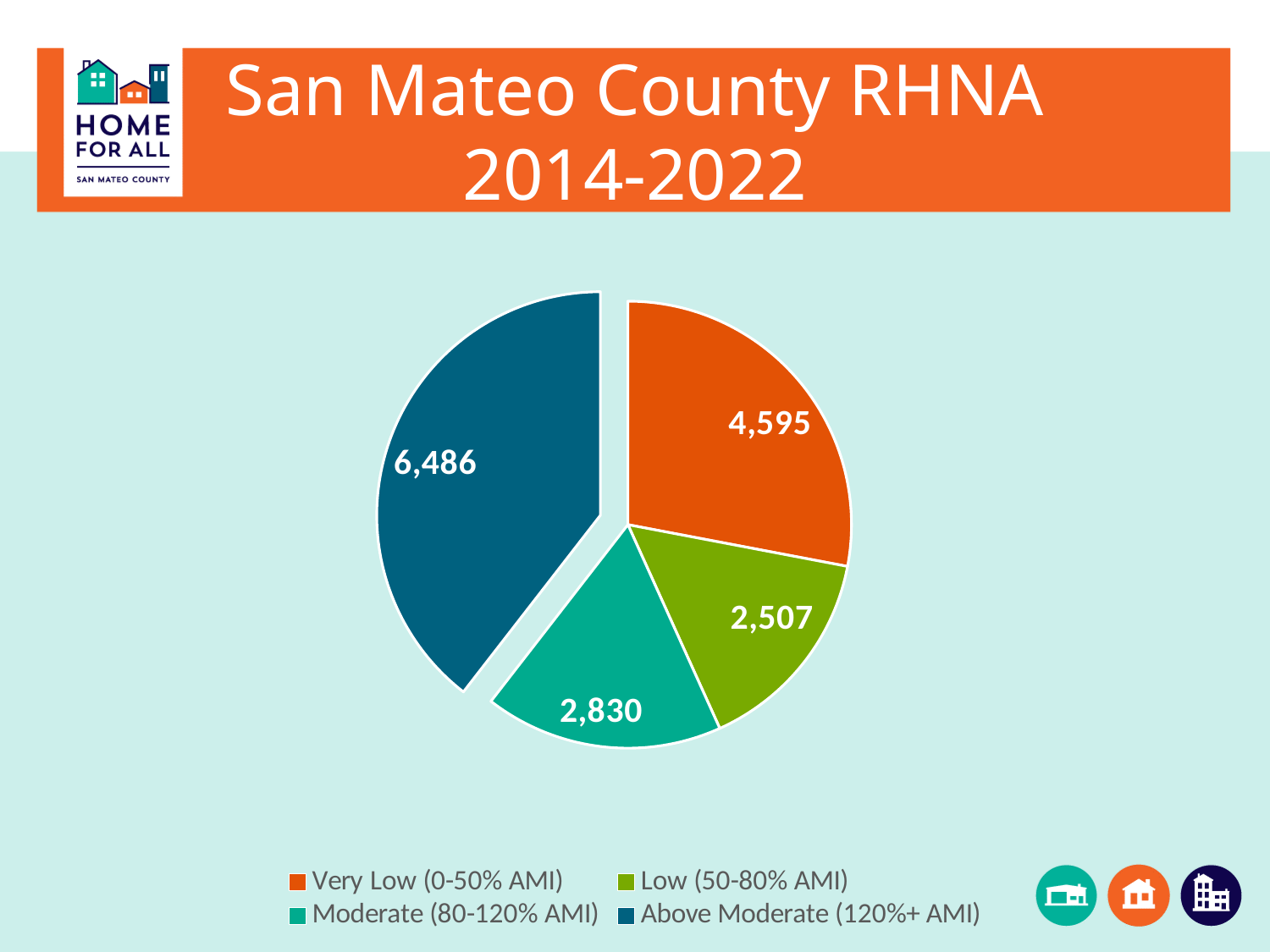
What is the value for Above Moderate (120%+ AMI)? 6,486 What is the value for Moderate (80-120% AMI)? 2,830 Which category has the smallest slice? Low (50-80% AMI) Which category has the largest slice? Above Moderate (120%+ AMI) What is the difference between the Above Moderate (120%+ AMI) and Very Low (0-50% AMI) values? 1,891 What type of chart is shown on the slide? Pie chart Which is larger, Moderate (80-120% AMI) or Low (50-80% AMI)? Moderate (80-120% AMI) What is the value for Low (50-80% AMI)? 2,507 What is the total of all four slices? 16,418 How many categories does the pie chart have? 4 What colour is the Very Low (0-50% AMI) slice? Orange What is the value for Very Low (0-50% AMI)? 4,595